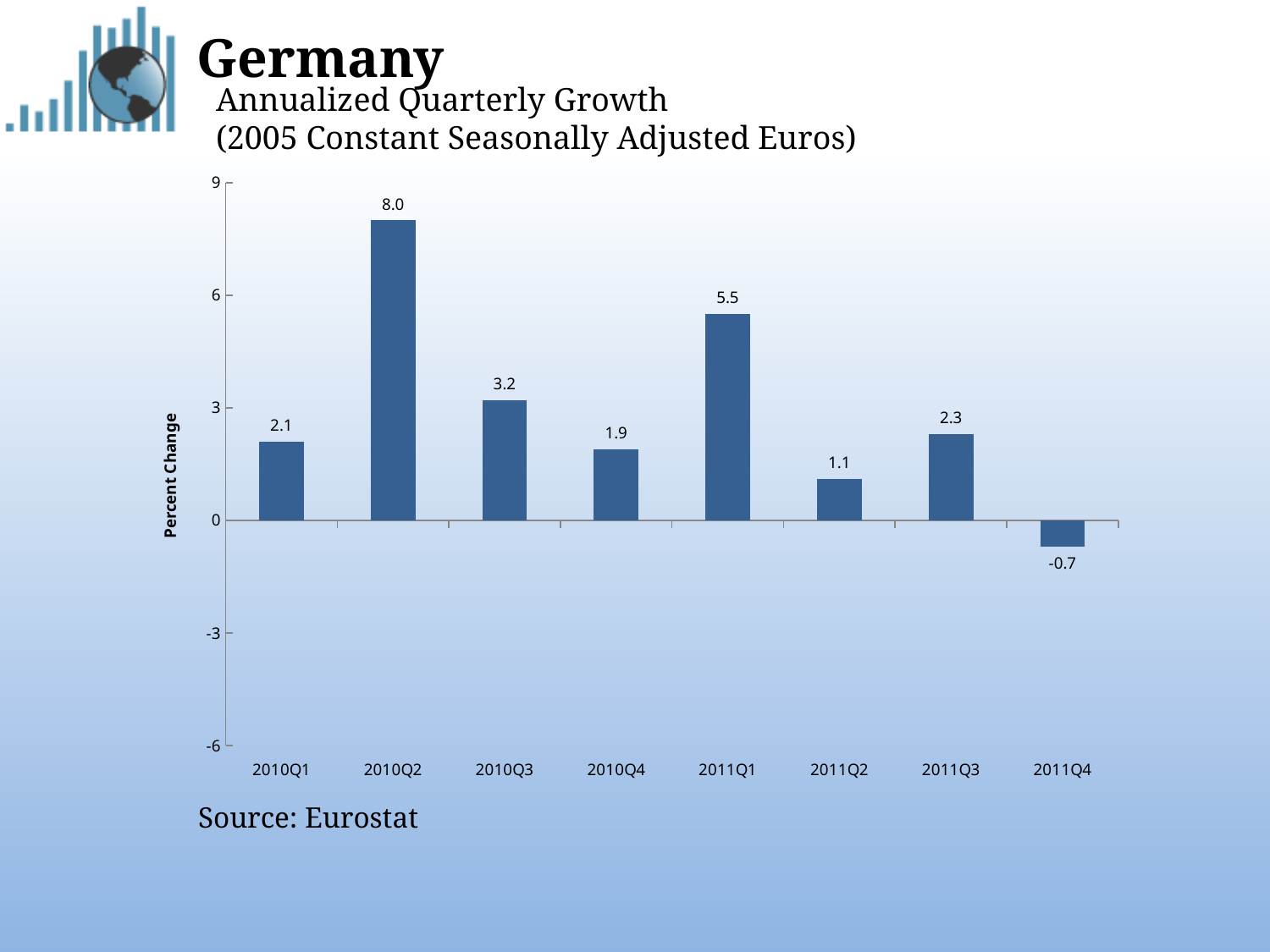
What kind of chart is shown on the slide? bar chart How many quarters are shown on the x axis? 8 Which is larger, the value for 2010Q3 or the value for 2011Q3? 2010Q3 What is the value shown for 2011Q4? -0.7 Which quarter has the highest annualized growth? 2010Q2 Which quarter has the lowest annualized growth? 2011Q4 Does the value rise or fall from 2011Q3 to 2011Q4? fall What is the difference between the values for 2010Q2 and 2011Q1? 2.5 What is the label on the vertical axis? Percent Change What is the annualized quarterly growth value for 2010Q2? 8.0 Is the value for 2010Q2 greater or less than 6? greater What is the value shown for 2011Q1? 5.5